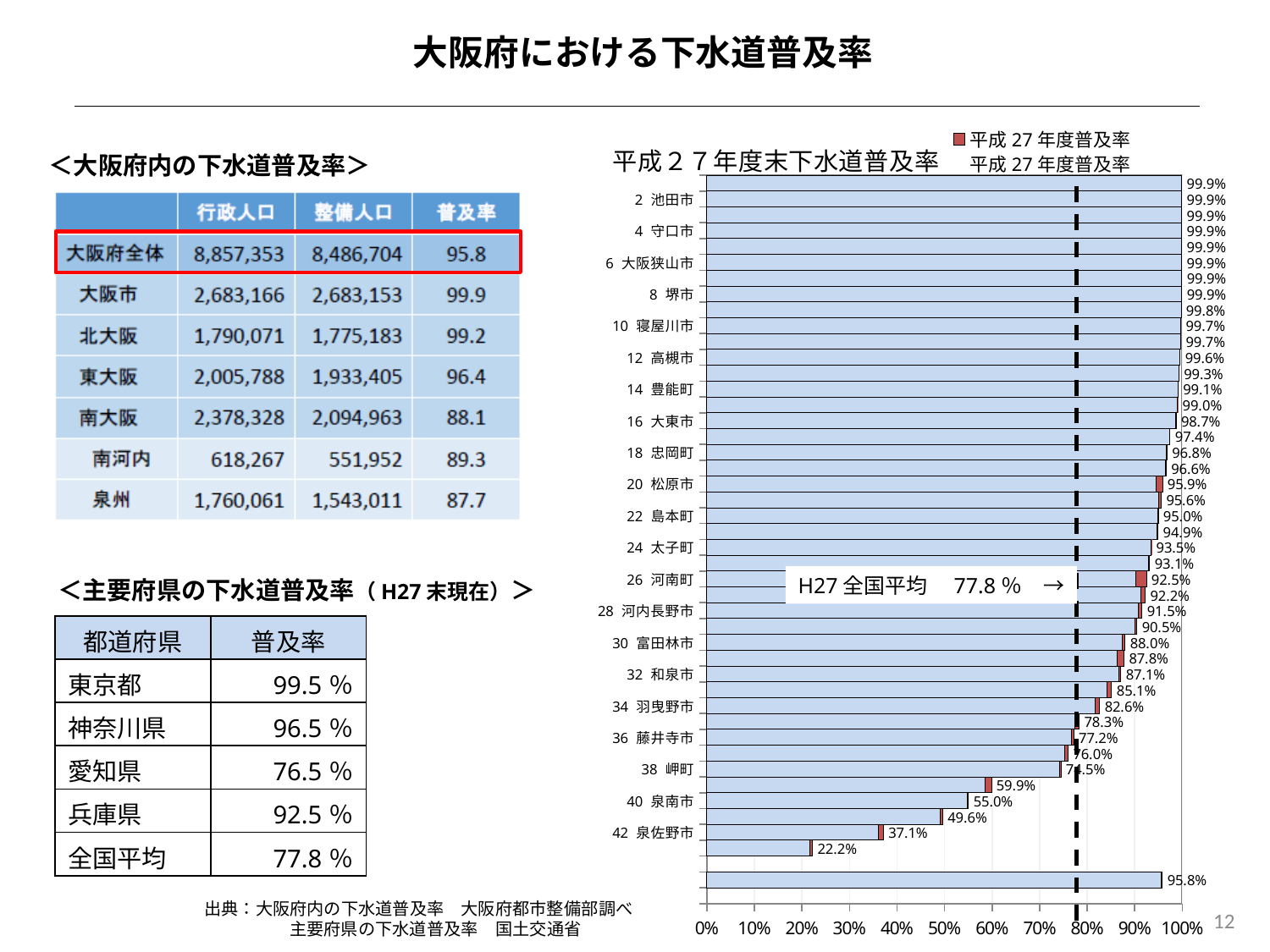
In the 平成２７年度末下水道普及率 chart, what is the lowest value shown on any bar? 22.2% In the 平成２７年度末下水道普及率 chart, what national average value (H27 全国平均) is annotated with the dashed line? 77.8% In the 平成２７年度末下水道普及率 chart, what is the difference between the values for 泉南市 and 泉佐野市? 17.9 percentage points In the 平成２７年度末下水道普及率 chart, which has the larger value, 和泉市 or 羽曳野市? 和泉市 In the 平成２７年度末下水道普及率 chart, what is the value for 泉佐野市? 37.1% What kind of chart is shown on the right side of the slide? bar chart In the 平成２７年度末下水道普及率 chart, do the bar values rise or fall going from the top of the chart to the bottom (excluding the final bar)? fall In the 平成２７年度末下水道普及率 chart, what is the value for 泉南市? 55.0% In the 平成２７年度末下水道普及率 chart, what is the value for 岬町? 74.5% In the 平成２７年度末下水道普及率 chart, is the value for 藤井寺市 greater or less than 50%? greater In the 平成２７年度末下水道普及率 chart, what is the value for 富田林市? 88.0% In the 平成２７年度末下水道普及率 chart, what is the value for 羽曳野市? 82.6%